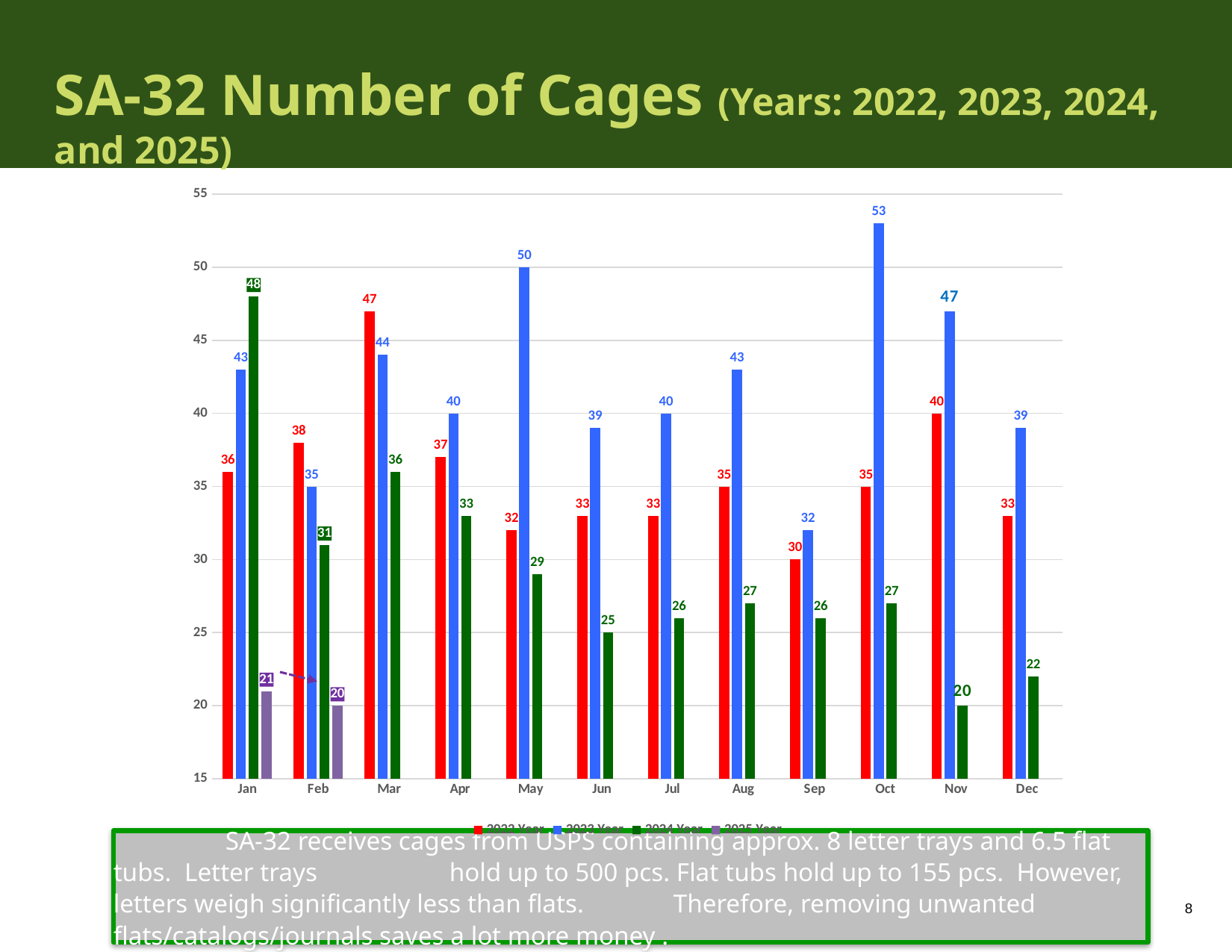
Which is larger for Jan: the red (2022) bar or the green (2024) bar? the green (2024) bar How many months are shown on the x axis? 12 What is the value of the purple (2025) bar for Feb? 20 What kind of chart is shown on the slide? bar chart What is the value of the green (2024) bar for Jan? 48 What is the difference between the red (2022) bars for Feb and Sep? 8 What is the difference between the blue (2023) and red (2022) bars for May? 18 What is the value of the blue (2023) bar for Oct? 53 In which month is the blue (2023) series highest? Oct In which month is the green (2024) series lowest? Nov How many months have a purple (2025) bar? 2 What is the value of the red (2022) bar for Mar? 47